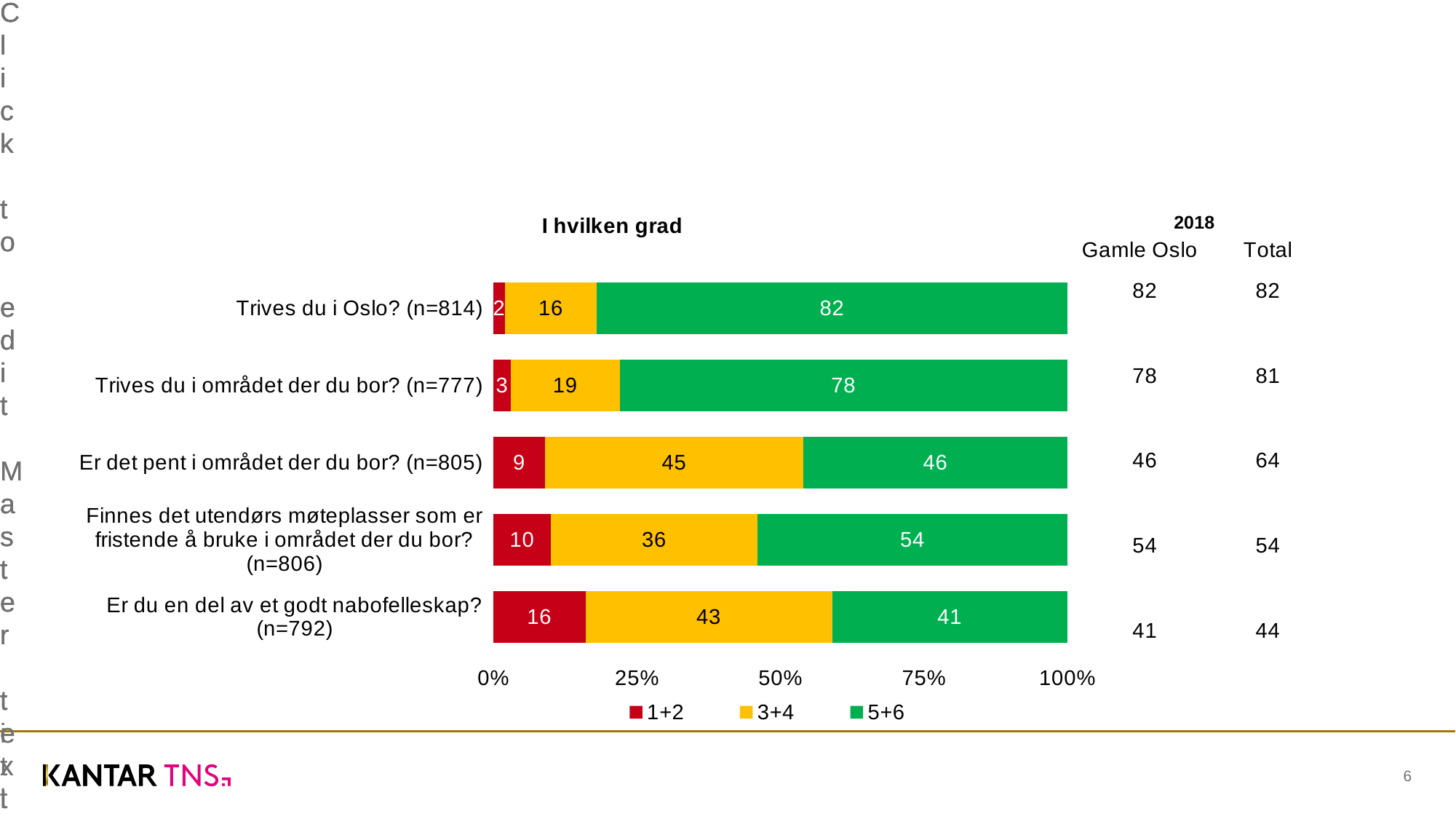
What is the difference between the 5+6 values for "Trives du i området der du bor? (n=777)" and "Er det pent i området der du bor? (n=805)"? 32 What kind of chart is shown on the slide? Stacked bar chart What is the 3+4 value for "Er det pent i området der du bor? (n=805)"? 45 Which category has the lowest 5+6 value? Er du en del av et godt nabofelleskap? (n=792) What is the title of the chart? I hvilken grad Which is larger: the 3+4 value for "Finnes det utendørs møteplasser som er fristende å bruke i området der du bor? (n=806)" or the 3+4 value for "Er du en del av et godt nabofelleskap? (n=792)"? Er du en del av et godt nabofelleskap? (n=792) How many series does the legend list? 3 What is the 5+6 value for "Trives du i Oslo? (n=814)"? 82 What is the 1+2 value for "Er du en del av et godt nabofelleskap? (n=792)"? 16 How many questions (categories) are plotted in the chart? 5 What is the total of the stacked bar for "Trives du i området der du bor? (n=777)"? 100 Which category has the highest 5+6 value? Trives du i Oslo? (n=814)